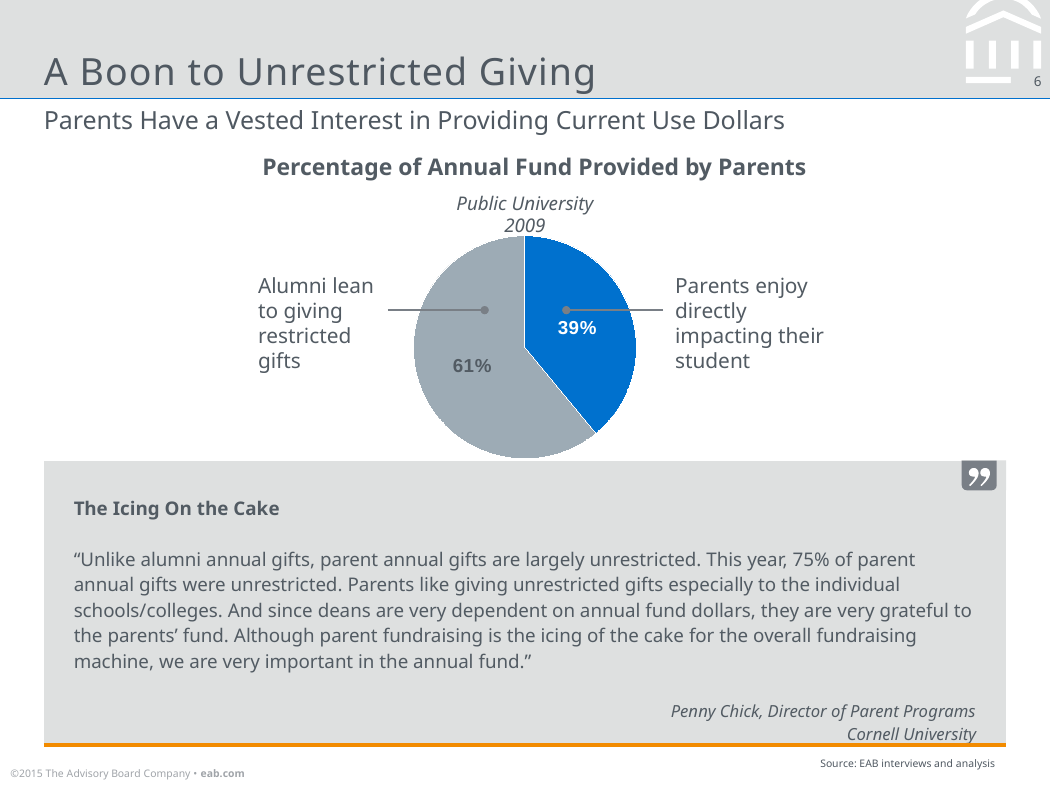
How many slices does the pie chart have? 2 Which slice of the pie chart is the smallest? 39% Which slice of the pie chart is the largest? 61% Is the parents' share of the annual fund greater or less than 50%? less What share of the pie chart is labeled 61%? the gray slice (alumni) What institution type and year does the pie chart refer to? Public University 2009 What is the difference in percentage points between the two slices of the pie chart? 22 percentage points What is the title of the chart? Percentage of Annual Fund Provided by Parents What is the total of the two slices shown in the pie chart? 100% What kind of chart is shown on the slide? pie chart Which slice of the pie chart is larger, the 39% slice or the 61% slice? the 61% slice What share of the annual fund is provided by parents according to the pie chart? 39%